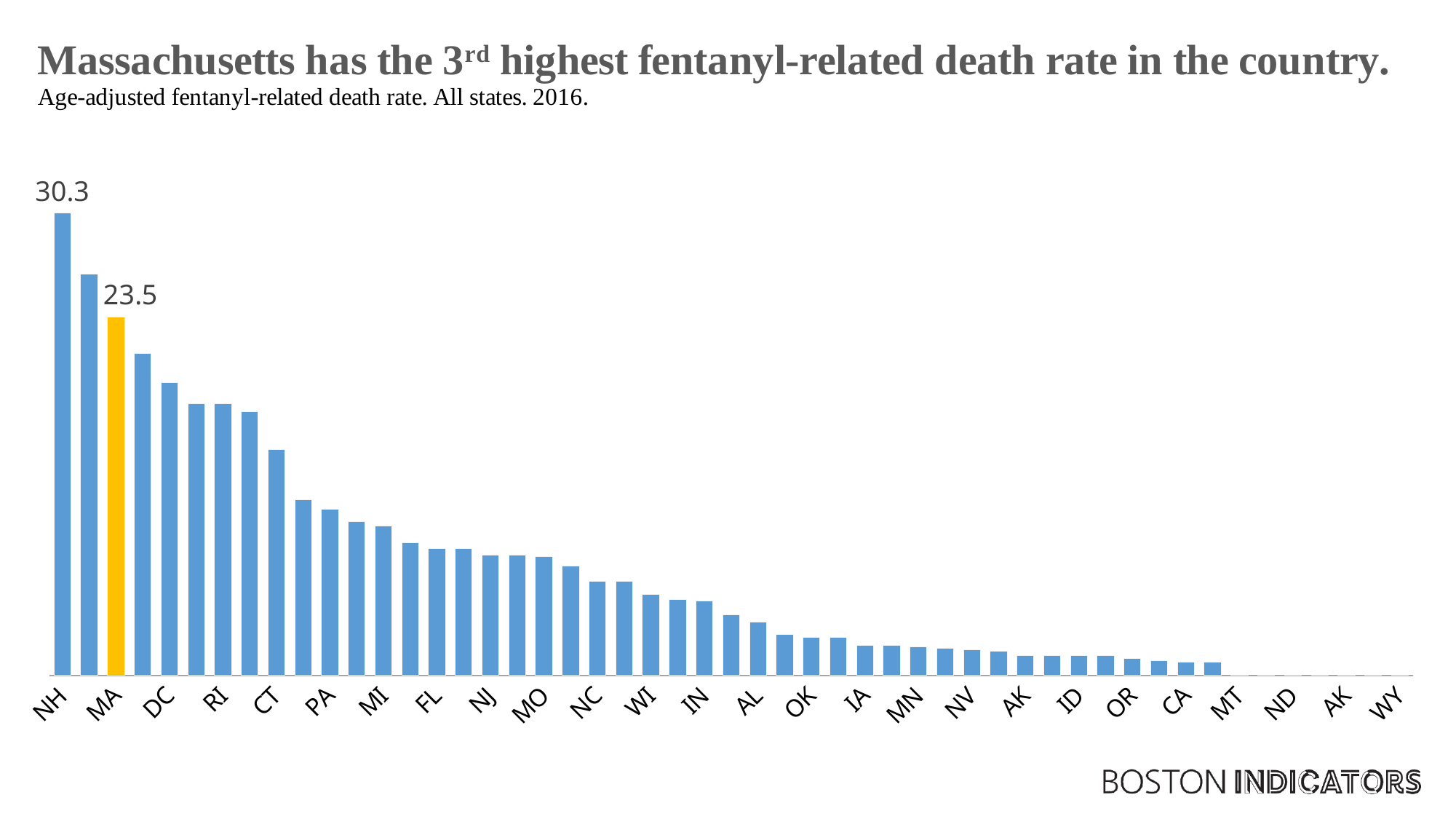
Do the bar values rise or fall moving from left to right along the x axis? fall What year does the chart's data refer to? 2016 What is the age-adjusted fentanyl-related death rate for MA? 23.5 Which has a higher fentanyl-related death rate, DC or RI? DC What is the age-adjusted fentanyl-related death rate for NH? 30.3 Which state's bar is highlighted in yellow? MA How many bars have a data label printed above them? 2 Which has a higher fentanyl-related death rate, NH or MA? NH What kind of chart is shown on the slide? bar chart Which state has the highest fentanyl-related death rate in the chart? NH Which has a higher fentanyl-related death rate, CT or PA? CT What is the difference between the death rates for NH and MA? 6.8